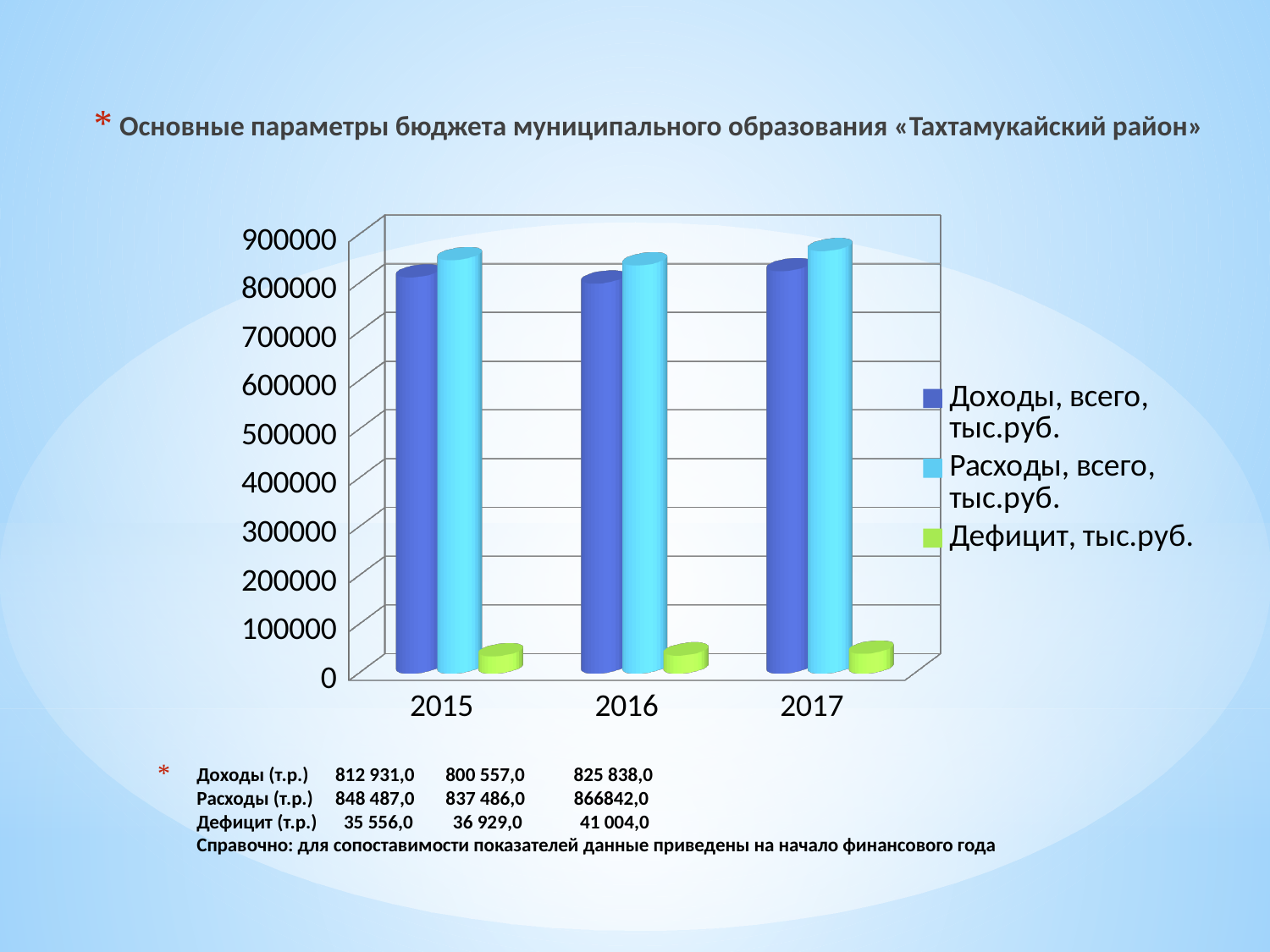
Is the value of Дефицит for 2017 greater or less than 100000? less In which year is Расходы, всего the highest? 2017 In 2015, which is larger: Доходы, всего or Расходы, всего? Расходы, всего How many years are shown on the x axis of the chart? 3 What is the difference between Расходы, всего and Доходы, всего in 2015? 35 556,0 Does the Дефицит series rise or fall from 2015 to 2017? rises What is the value of Доходы, всего for 2015? 812 931,0 What is the value of Расходы, всего for 2017? 866842,0 What is the value of Дефицит for 2016? 36 929,0 In which year is Доходы, всего the lowest? 2016 How many series does the chart legend list? 3 What kind of chart is shown on the slide? bar chart